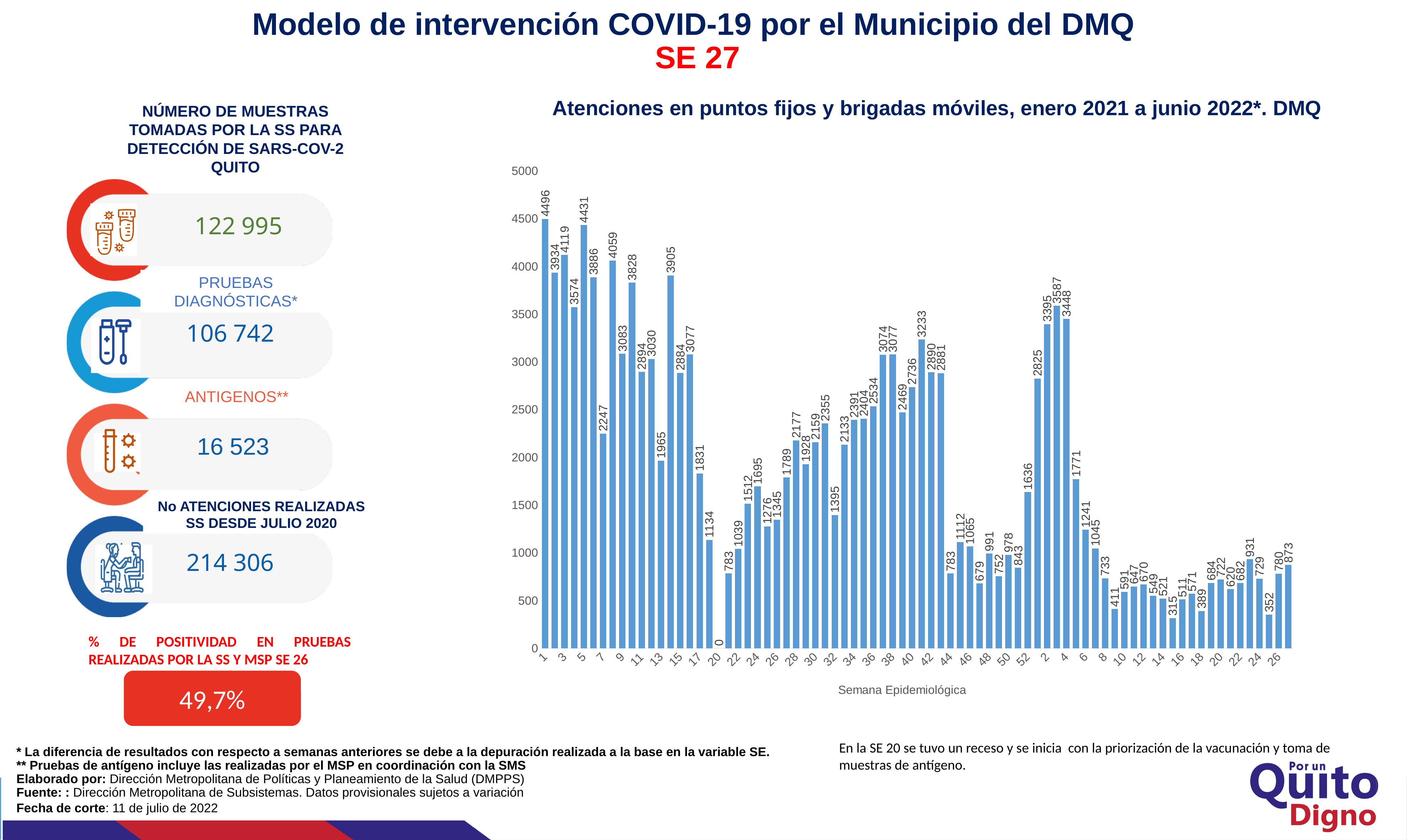
What is the difference between the values for semana epidemiológica 52 (1636) and semana epidemiológica 44 (783) in the bar chart? 853 What is the value shown for semana epidemiológica 40 in the bar chart? 2736 Is the value for semana epidemiológica 48 in the bar chart greater or less than 1000? less What is the label of the horizontal axis of the bar chart? Semana Epidemiológica What is the value shown for semana epidemiológica 52 in the bar chart? 1636 What is the value shown for semana epidemiológica 44 in the bar chart? 783 What is the value of the first bar (semana epidemiológica 1 of 2021) in the bar chart? 4496 Which has a larger value in the bar chart, semana epidemiológica 42 or semana epidemiológica 44? Semana epidemiológica 42 What is the value shown for semana epidemiológica 36 in the bar chart? 2534 What is the value shown for semana epidemiológica 20 in the bar chart? 0 What is the highest value shown in the bar chart of atenciones? 4496 What kind of chart is shown under the title 'Atenciones en puntos fijos y brigadas móviles, enero 2021 a junio 2022*. DMQ'? Bar chart